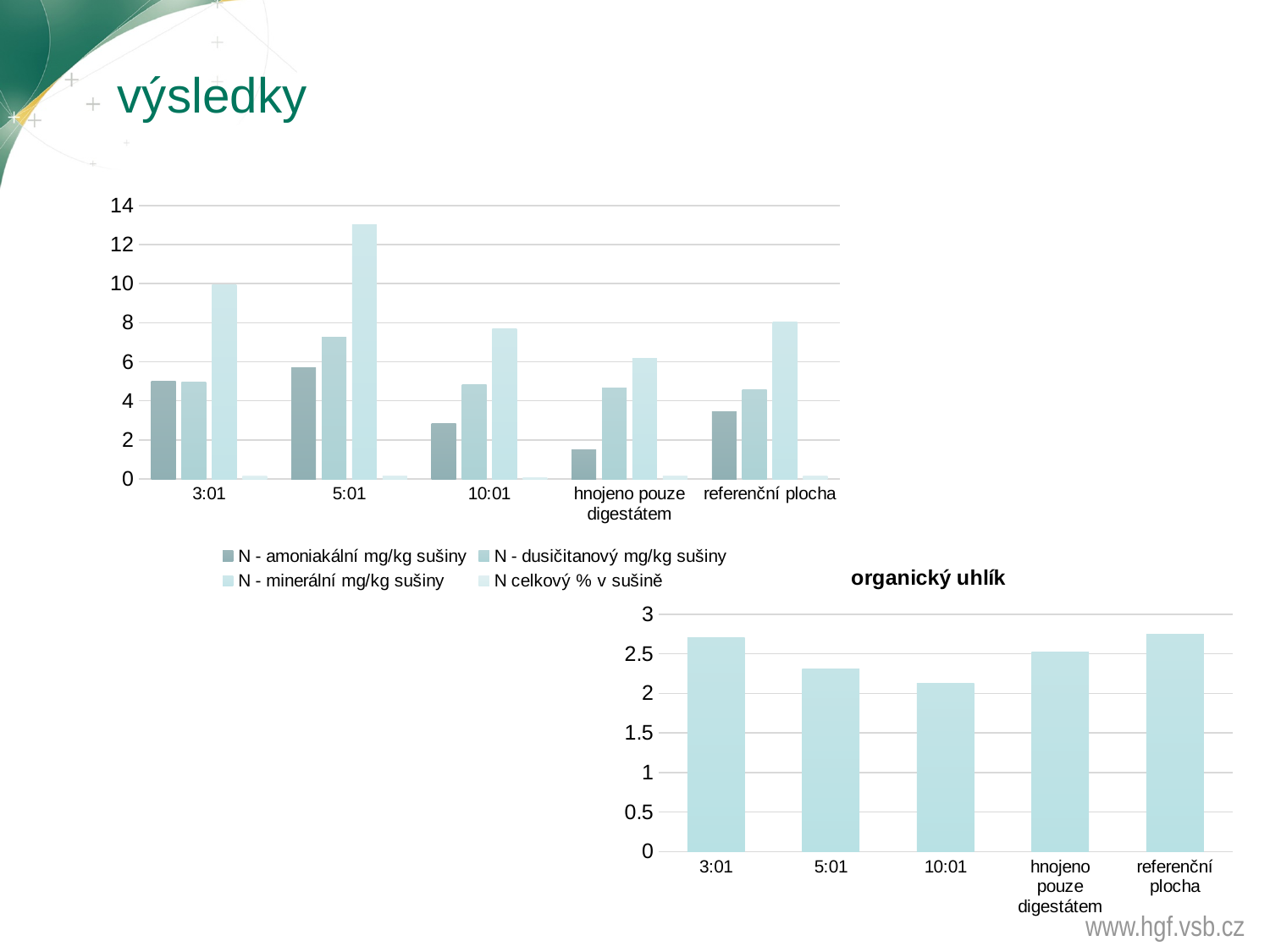
In the top-left chart, which category has the highest value for N - minerální mg/kg sušiny? 5:01 In the top-left chart, which category has the lowest value for N - amoniakální mg/kg sušiny? hnojeno pouze digestátem In the top-left chart, how many series does the legend list? 4 In the chart titled "organický uhlík", is the value for 3:01 greater or less than 2.5? greater What is the title of the chart in the bottom-right of the slide? organický uhlík In the chart titled "organický uhlík", which category has the lowest value? 10:01 What kind of chart is the chart titled "organický uhlík"? bar chart In the chart titled "organický uhlík", how many categories are shown on the x axis? 5 In the top-left chart, is the value of N - minerální mg/kg sušiny for 5:01 greater or less than 12? greater In the chart titled "organický uhlík", is the value for 10:01 greater or less than 2.5? less In the top-left chart, which is larger for N - amoniakální mg/kg sušiny: 5:01 or 10:01? 5:01